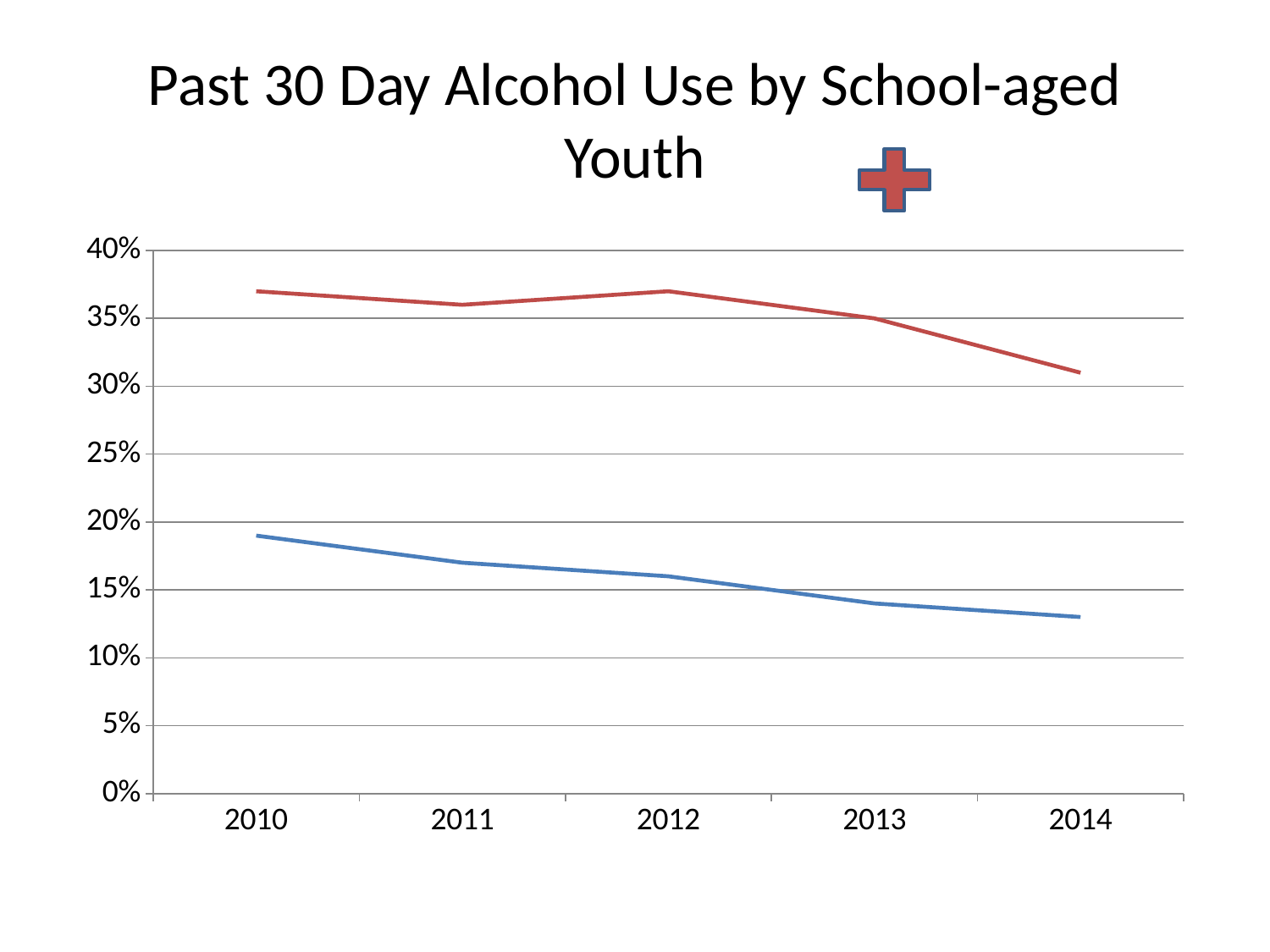
Is the value of the red line in 2013 greater or less than 30%? greater Is the value of the red line in 2010 greater or less than 35%? greater Is the value of the blue line in 2010 greater or less than 20%? less In 2014, which line has the higher value, the red line or the blue line? the red line In which year is the blue line at its highest value? 2010 How many years are shown on the x axis of the chart? 5 In which year is the red line at its lowest value? 2014 How many lines are plotted on the chart? 2 What is the title of the chart? Past 30 Day Alcohol Use by School-aged Youth Does the blue line rise or fall from 2010 to 2014? fall What kind of chart is shown on the slide? line chart